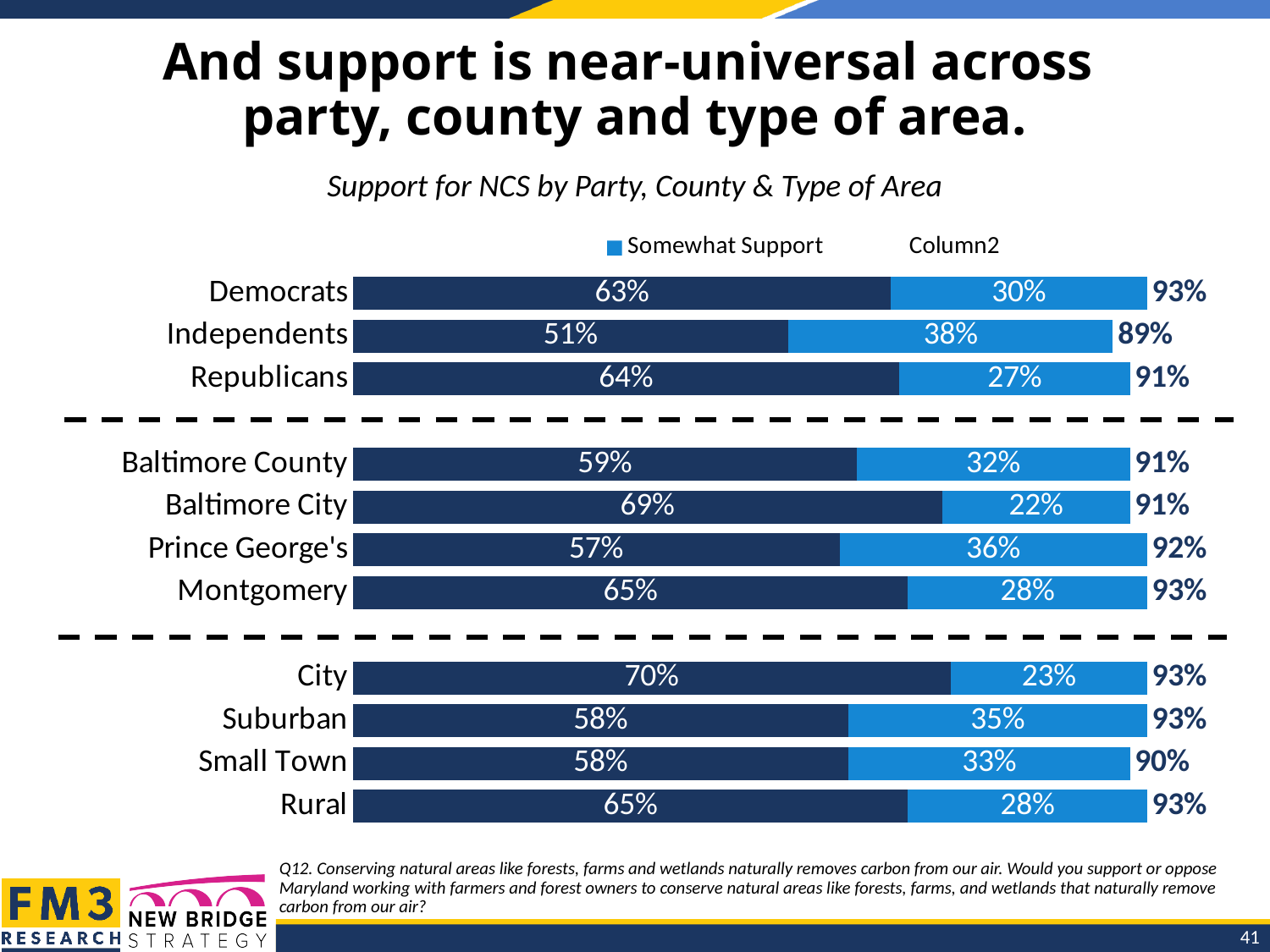
Which has a larger dark blue segment, Republicans or Independents? Republicans What total percentage is shown at the end of the Independents bar? 89% What is the value of the dark blue segment for Democrats? 63% Which category has the smallest light blue segment? Baltimore City What is the value of the light blue segment for Prince George's? 36% How many categories are plotted in the chart? 11 What is the total of the stacked bar for Small Town? 90% How many series does the legend list? 2 Which category has the largest dark blue segment? City Which category has the lowest total shown at the end of its bar? Independents What is the difference between the dark blue and light blue segments for Baltimore City? 47 percentage points What kind of chart is shown on the slide? Stacked bar chart